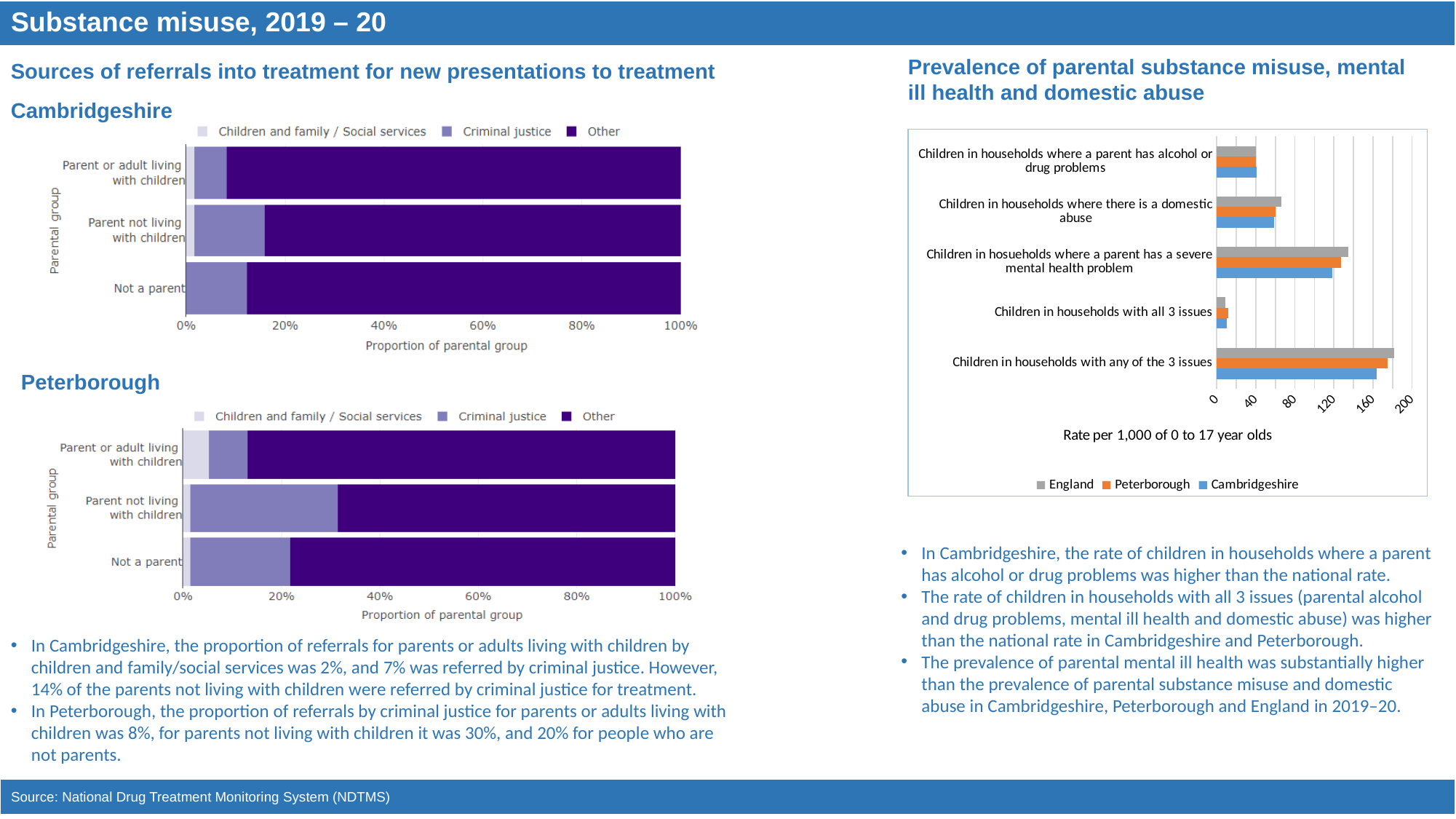
On the 'Prevalence of parental substance misuse, mental ill health and domestic abuse' chart, is the England rate for 'Children in households where a parent has a severe mental health problem' greater or less than 120? greater In the Peterborough chart, is the Criminal justice share larger for 'Parent not living with children' or for 'Not a parent'? Parent not living with children In the Peterborough chart, is the Criminal justice share for 'Parent not living with children' greater or less than 20%? greater How many series does the legend of the 'Prevalence of parental substance misuse, mental ill health and domestic abuse' chart list? 3 What kind of chart is the Cambridgeshire chart? stacked bar chart On the 'Prevalence of parental substance misuse, mental ill health and domestic abuse' chart, which category has the lowest Cambridgeshire rate? Children in households with all 3 issues How many parental groups are shown on the Cambridgeshire chart? 3 On the 'Prevalence of parental substance misuse, mental ill health and domestic abuse' chart, which category has the highest England rate? Children in households with any of the 3 issues In the Cambridgeshire chart, which series is listed first in the legend? Children and family / Social services How many series does the legend of the Peterborough chart list? 3 In the Cambridgeshire chart, is the Criminal justice share larger for 'Parent not living with children' or for 'Parent or adult living with children'? Parent not living with children How many categories are shown on the 'Prevalence of parental substance misuse, mental ill health and domestic abuse' chart? 5